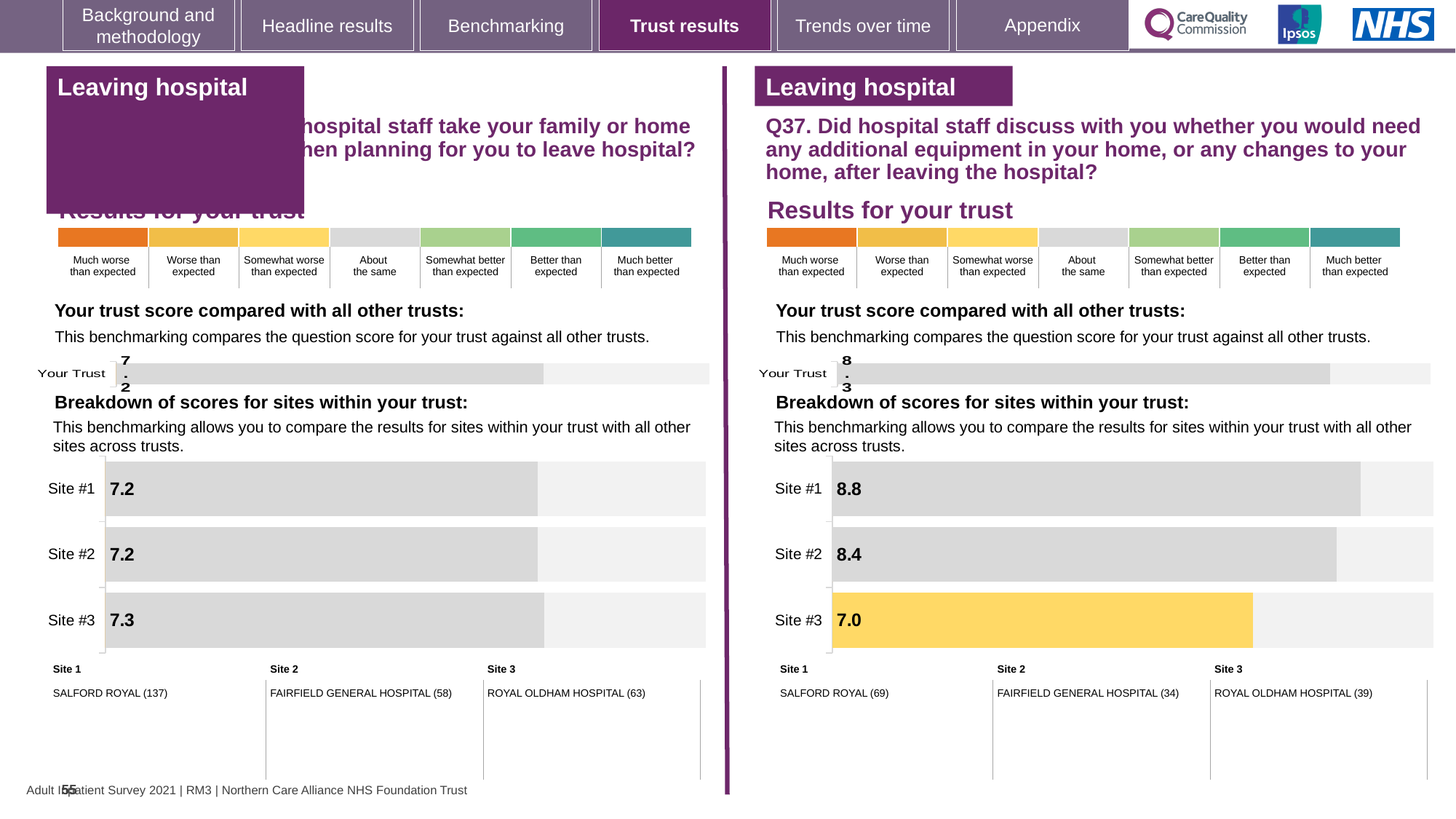
In the left-hand site breakdown chart, what is the score for Site #3? 7.3 In the right-hand chart for Q37, which site has the highest score in the site breakdown? Site #1 In the right-hand chart for Q37, what is the difference between the scores for Site #1 and Site #3? 1.8 In the right-hand chart for Q37, what is the 'Your Trust' score compared with all other trusts? 8.3 In the right-hand chart for Q37, what is the score for Site #1 in the breakdown of scores for sites within your trust? 8.8 How many sites are shown in the left-hand site breakdown chart? 3 In the right-hand chart for Q37, which has the larger score, Site #2 or Site #3? Site #2 In the left-hand site breakdown chart, what is the difference between the scores for Site #3 and Site #1? 0.1 In the right-hand chart for Q37, which site has the lowest score in the site breakdown? Site #3 What kind of chart is used for the site breakdown on the right-hand side of the slide? Bar chart In the right-hand chart for Q37, what is the score for Site #3 in the site breakdown? 7.0 In the left-hand chart, what is the 'Your Trust' score compared with all other trusts? 7.2